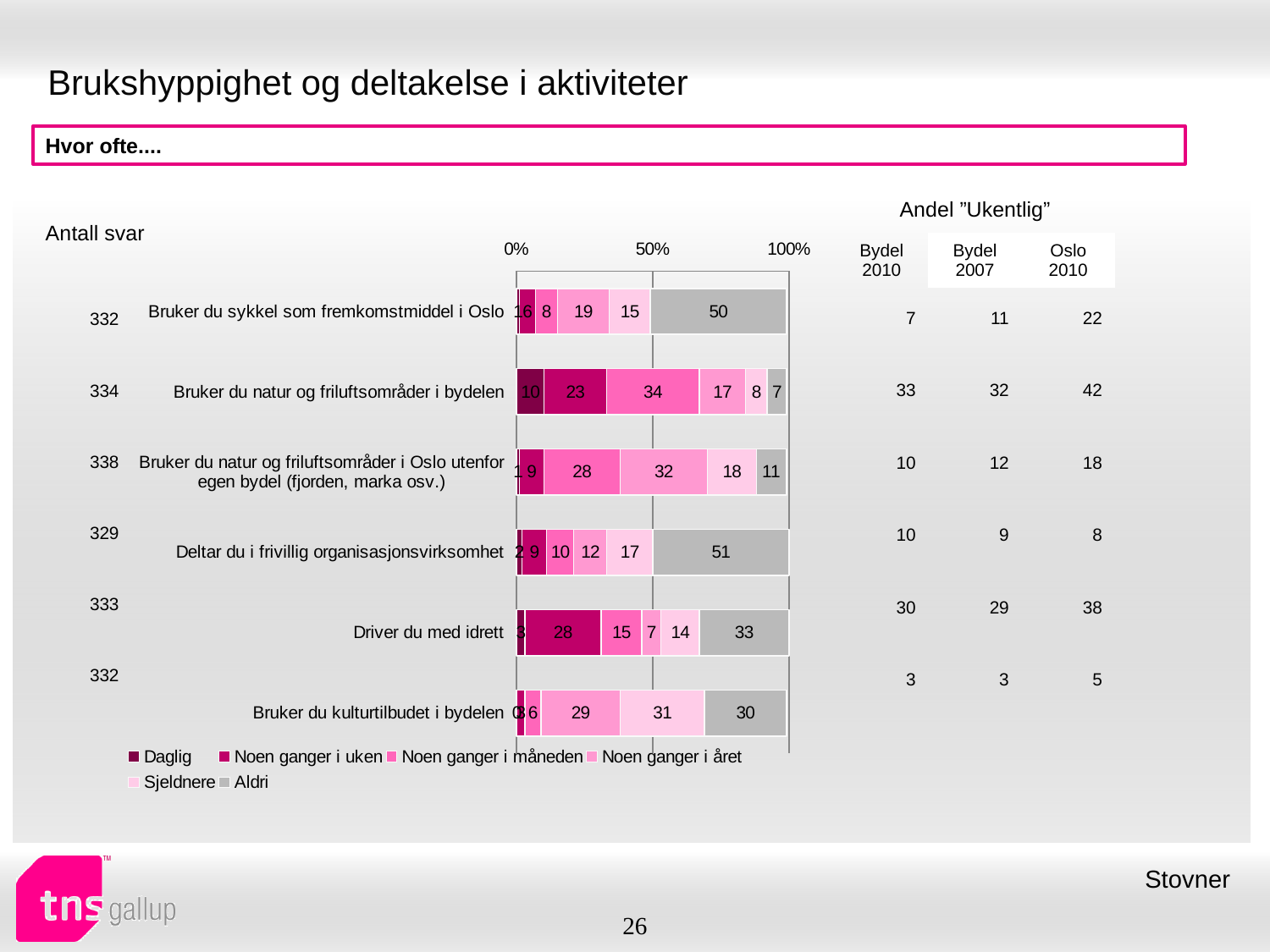
What is the 'Noen ganger i året' value for 'Bruker du natur og friluftsområder i Oslo utenfor egen bydel (fjorden, marka osv.)'? 32 What kind of chart is shown on the slide? Stacked bar chart What is the 'Noen ganger i måneden' value for 'Bruker du natur og friluftsområder i bydelen'? 34 What is the 'Aldri' value for 'Bruker du kulturtilbudet i bydelen'? 30 Which has the larger 'Noen ganger i uken' value: 'Driver du med idrett' or 'Bruker du natur og friluftsområder i bydelen'? Driver du med idrett How many activity categories are plotted in the chart? 6 What is the first entry in the chart legend? Daglig What is the 'Aldri' value for 'Bruker du sykkel som fremkomstmiddel i Oslo'? 50 How many series does the chart legend list? 6 What is the 'Aldri' value for 'Deltar du i frivillig organisasjonsvirksomhet'? 51 Which category has the highest 'Aldri' value? Deltar du i frivillig organisasjonsvirksomhet What is the difference between the 'Aldri' value for 'Bruker du sykkel som fremkomstmiddel i Oslo' and the 'Aldri' value for 'Driver du med idrett'? 17